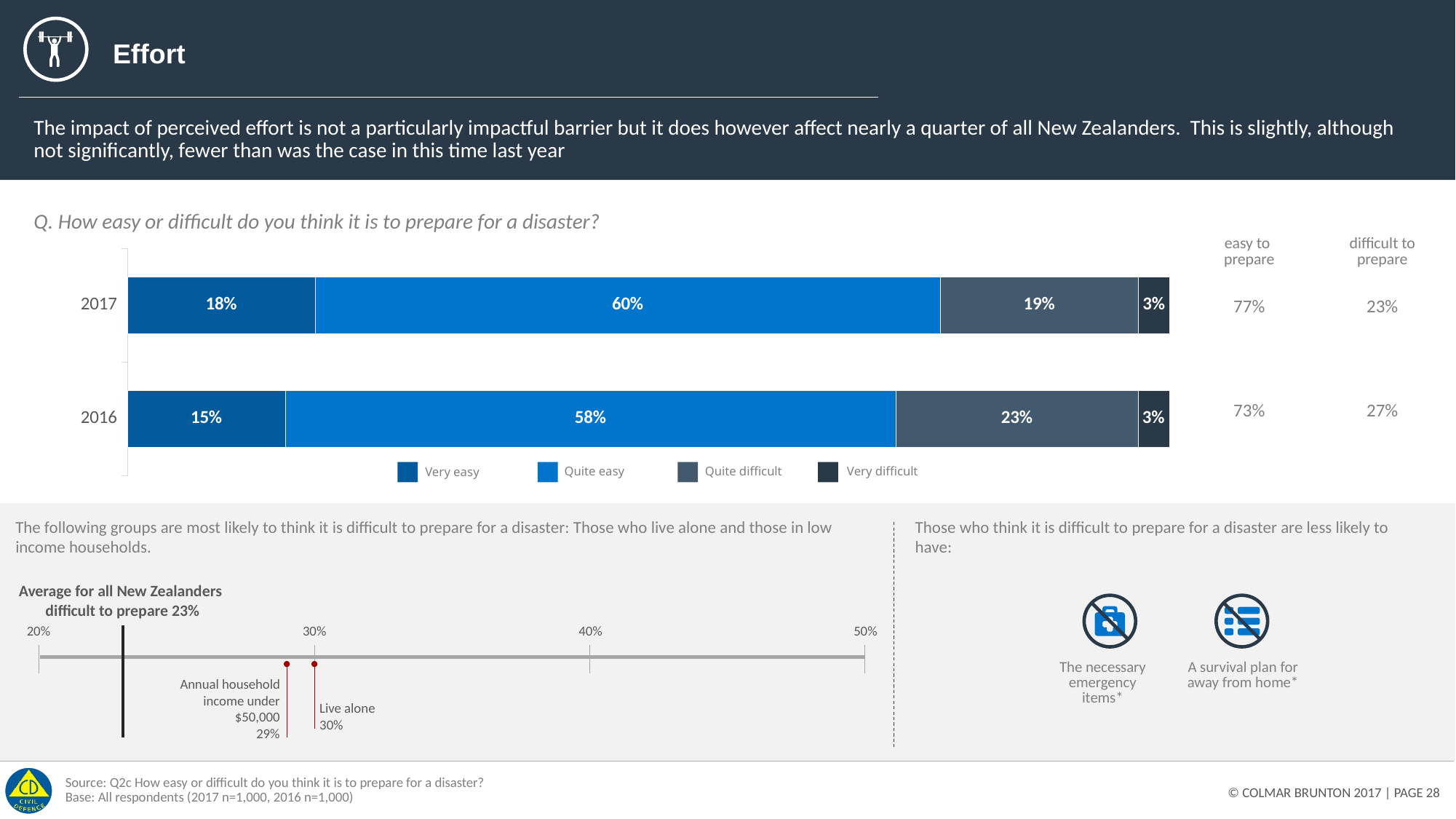
In the stacked bar chart, what is the difference between the 'Quite difficult' share in 2016 and in 2017? 4% In the stacked bar chart, what percentage of respondents in 2017 said it is 'Very difficult' to prepare for a disaster? 3% In the stacked bar chart, which response category has the smallest share in 2016? Very difficult What type of chart is used to show responses to 'How easy or difficult do you think it is to prepare for a disaster?' Stacked bar chart In the stacked bar chart, which response category has the largest share in 2017? Quite easy In the stacked bar chart, what percentage of respondents in 2016 said it is 'Quite easy' to prepare for a disaster? 58% According to the summary columns next to the stacked bar chart, what percentage found it 'difficult to prepare' in 2016? 27% In the stacked bar chart, what percentage of respondents in 2016 said it is 'Quite difficult' to prepare for a disaster? 23% How many series does the legend of the stacked bar chart list? 4 In the lower-left dot chart, what percentage of those who live alone think it is difficult to prepare? 30% In the stacked bar chart, which year has the larger 'Very easy' share, 2017 or 2016? 2017 In the stacked bar chart, what percentage of respondents in 2017 said it is 'Very easy' to prepare for a disaster? 18%